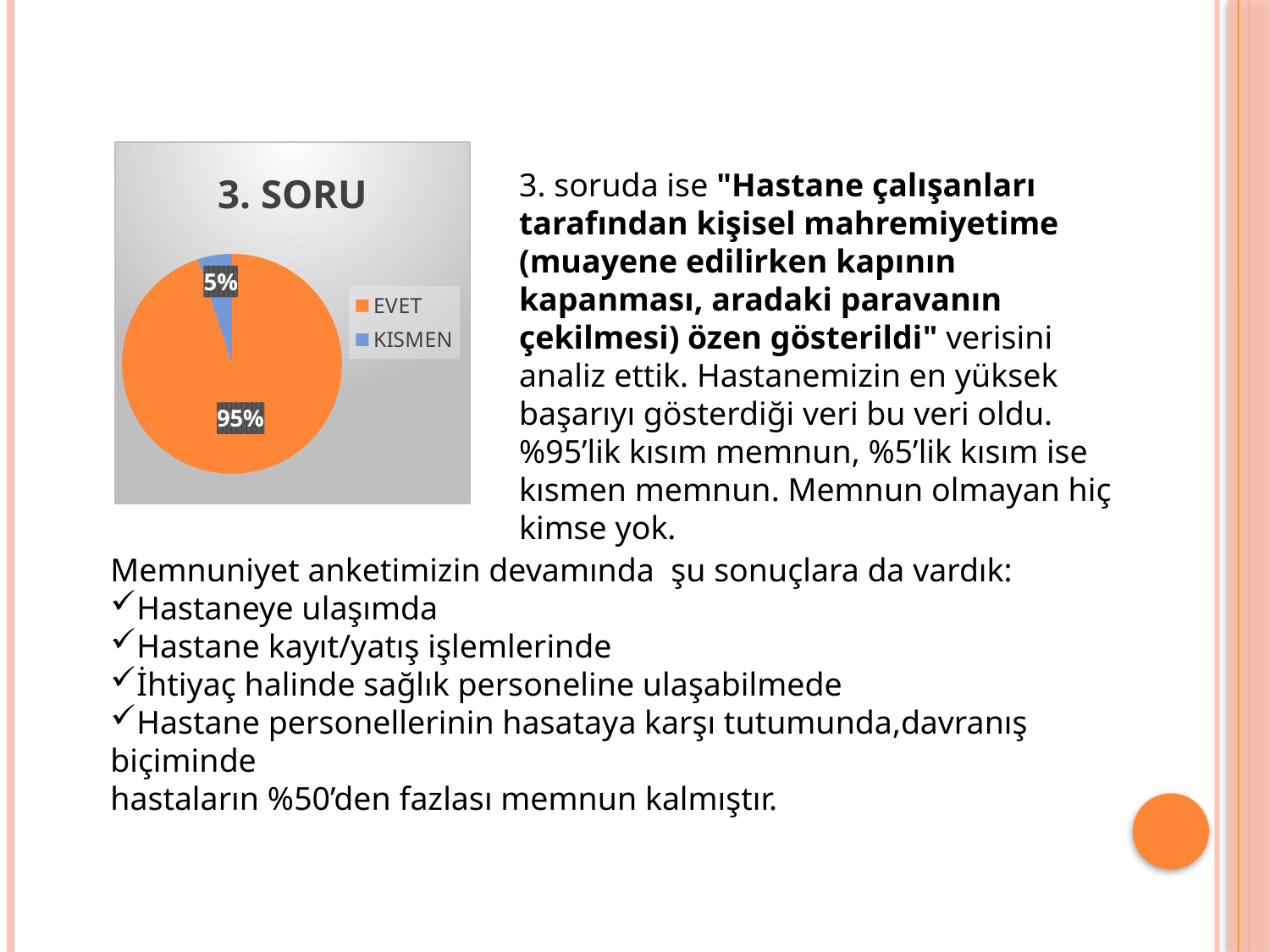
How many categories does the legend list? 2 What colour is the EVET slice? orange What share of the pie does KISMEN represent? 5% Which category has the smallest slice of the pie? KISMEN What share of the pie does EVET represent? 95% Which is larger, the EVET slice or the KISMEN slice? EVET What is the difference in percentage points between the EVET and KISMEN slices? 90 What is the title of the chart? 3. SORU Which category has the largest slice of the pie? EVET What kind of chart is shown on the slide? pie chart